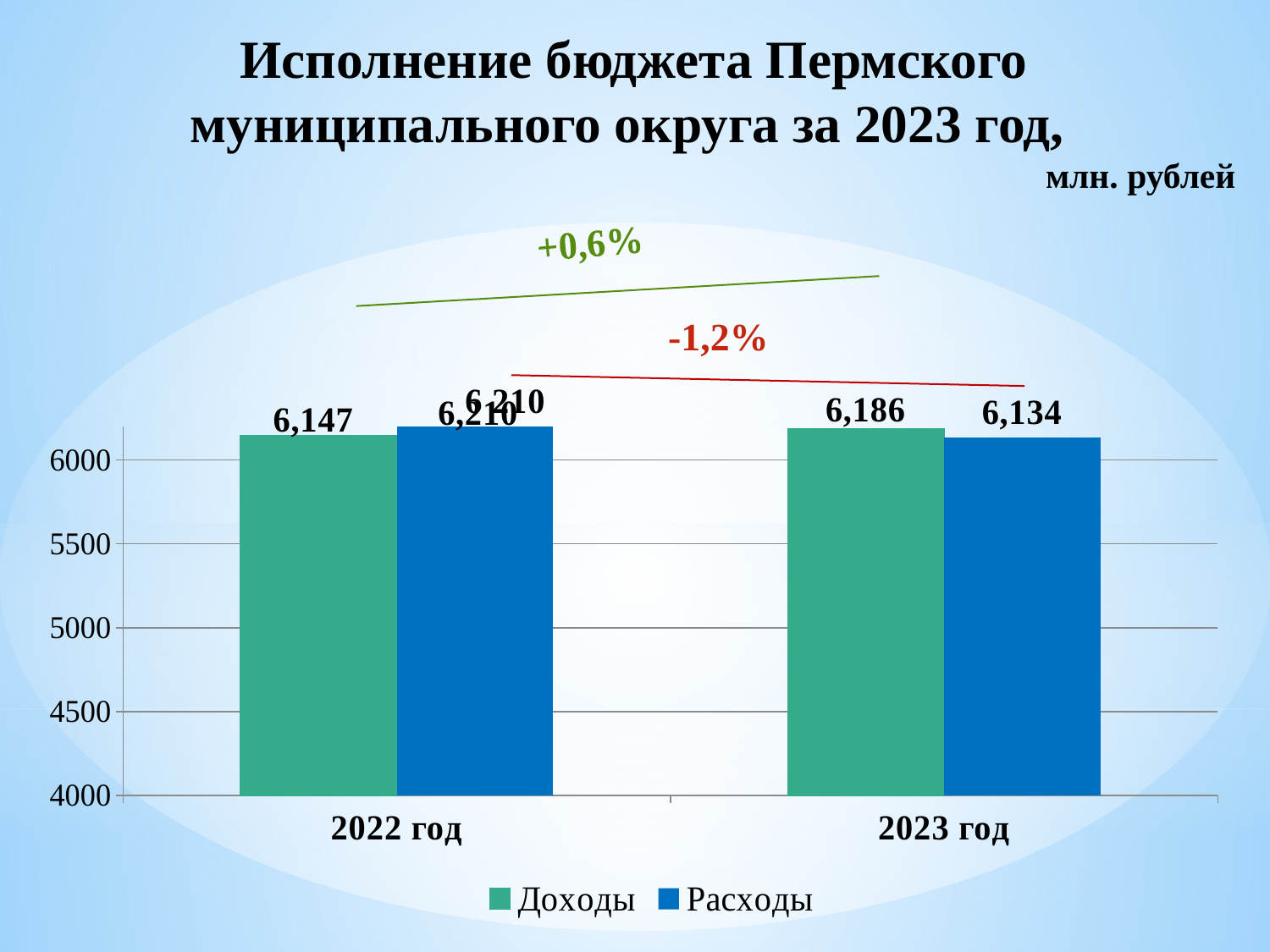
Which is larger in 2023 год, Доходы or Расходы? Доходы Which bar has the highest value on the chart? Расходы, 2022 год What is the value for Доходы in 2022 год? 6,147 What is the value for Расходы in 2022 год? 6,210 What is the value for Расходы in 2023 год? 6,134 What is the difference between Доходы and Расходы in 2023 год? 52 What is the value for Доходы in 2023 год? 6,186 How many series does the legend list? 2 What percentage change is shown in green above the chart? +0,6% What is the difference between Расходы and Доходы in 2022 год? 63 What kind of chart is shown on the slide? Bar chart Which bar has the lowest value on the chart? Расходы, 2023 год